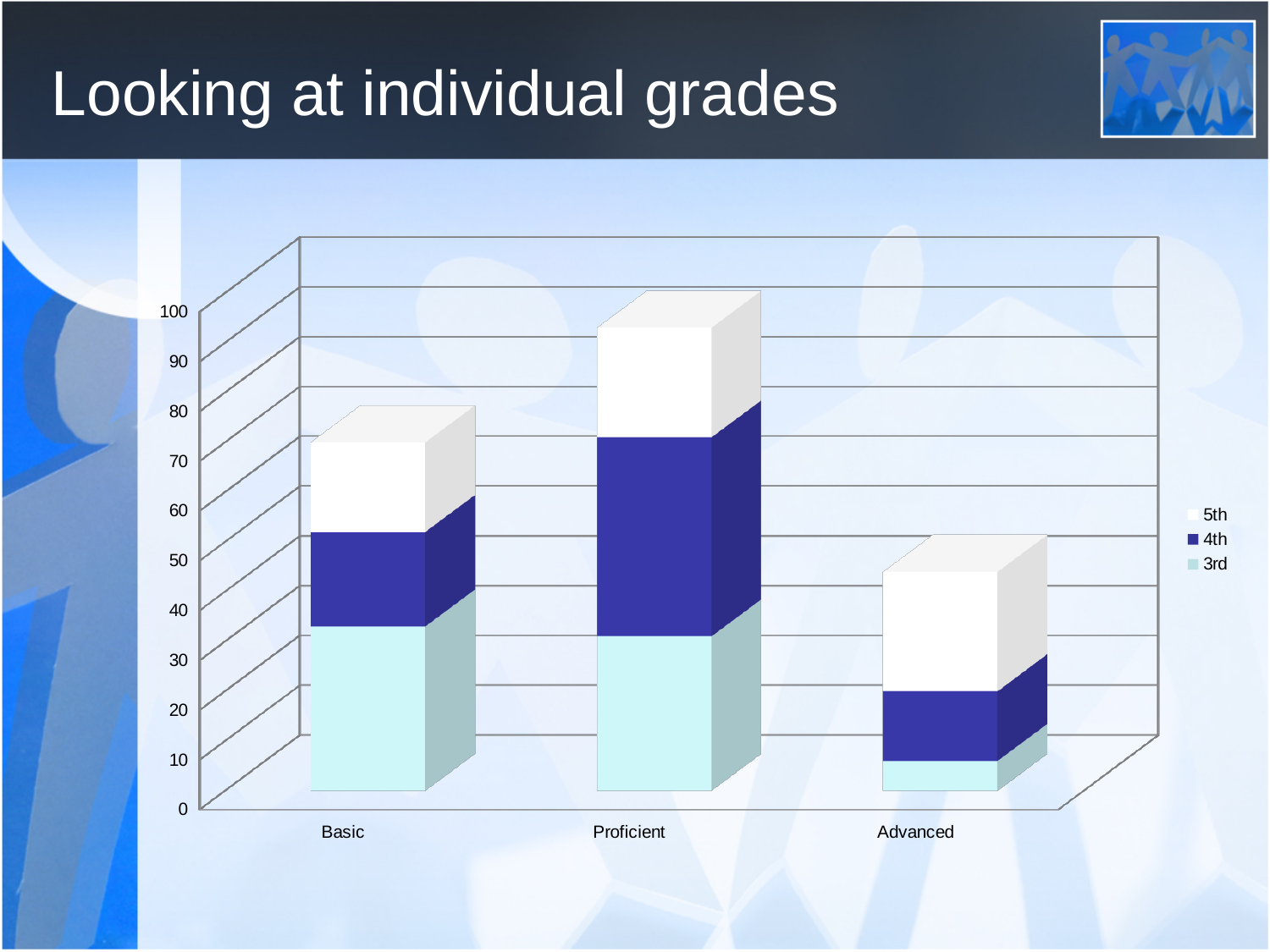
What is the title of the slide containing the chart? Looking at individual grades Is the total stacked bar for Proficient greater or less than 90? greater Which category has the largest 4th segment? Proficient Which stacked bar is taller, Basic or Advanced? Basic Is the total stacked bar for Basic greater or less than 60? greater How many series does the legend list? 3 What kind of chart is shown on the slide? stacked bar chart Which category has the tallest stacked bar? Proficient How many categories are shown on the x axis? 3 Which category has the shortest stacked bar? Advanced Is the total stacked bar for Advanced greater or less than 60? less